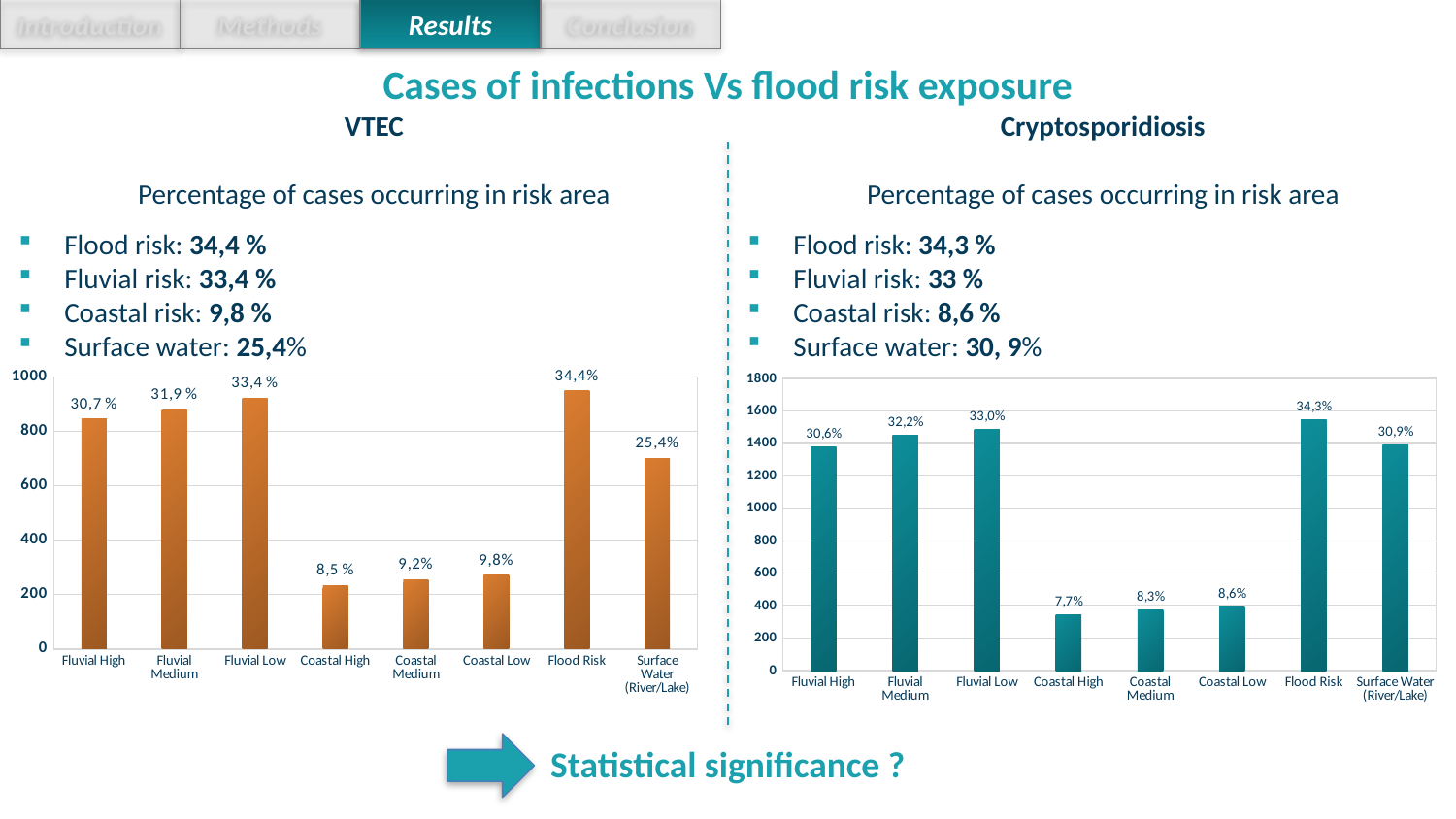
On the VTEC chart, which category has the tallest bar? Flood Risk On the VTEC chart, is the bar for Flood Risk greater or less than 800? greater On the Cryptosporidiosis chart, is the bar for Coastal High greater or less than 400? less On the VTEC chart, what percentage label is shown for Coastal High? 8,5 % On the Cryptosporidiosis chart, which bar is taller: Fluvial Low or Surface Water (River/Lake)? Fluvial Low On the VTEC chart, what percentage label is shown for Flood Risk? 34,4% On the Cryptosporidiosis chart, what percentage label is shown for Surface Water (River/Lake)? 30,9% What is the main title of the slide above the two charts? Cases of infections Vs flood risk exposure On the Cryptosporidiosis chart, what percentage label is shown for Fluvial Medium? 32,2% How many categories are shown on the VTEC chart? 8 On the Cryptosporidiosis chart, which category has the shortest bar? Coastal High What type of chart is the Cryptosporidiosis chart? Bar chart